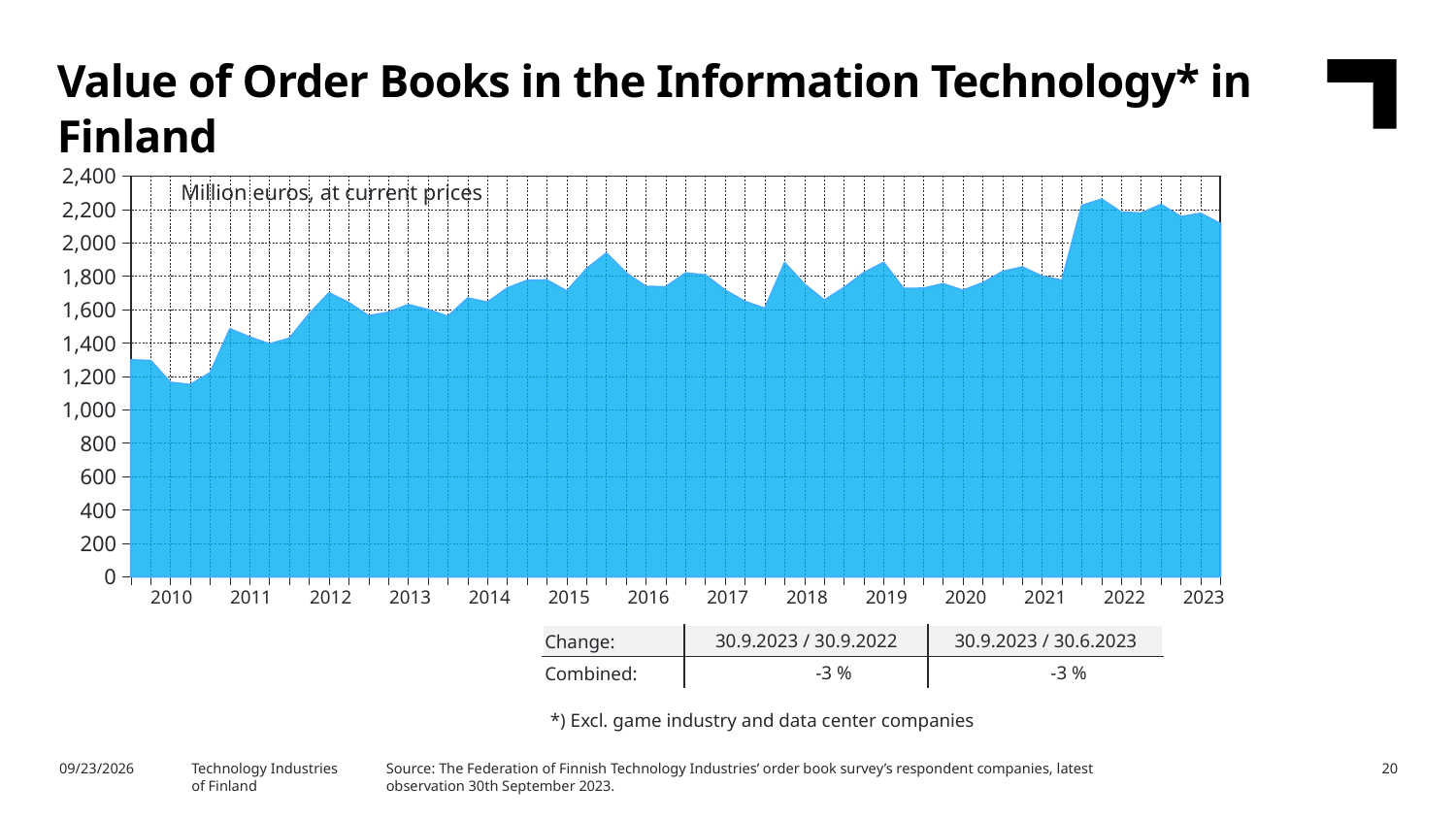
Is the lowest value in 2010 greater or less than 1,400? less In which year does the chart reach its lowest value? 2010 Overall, do the values rise or fall from 2010 to 2023? rise Is the value at the start of 2022 greater or less than 2,000? greater What is the title of the chart? Value of Order Books in the Information Technology* in Finland What kind of chart is shown on the slide? area chart Which is larger, the value at the start of 2010 or the value at the start of 2023? 2023 Is the value at the end of 2023 greater or less than 2,000? greater In which year does the chart reach its highest value? 2022 In what unit are the values on the chart expressed, according to the label inside the plot area? Million euros, at current prices How many year labels are shown on the x axis? 14